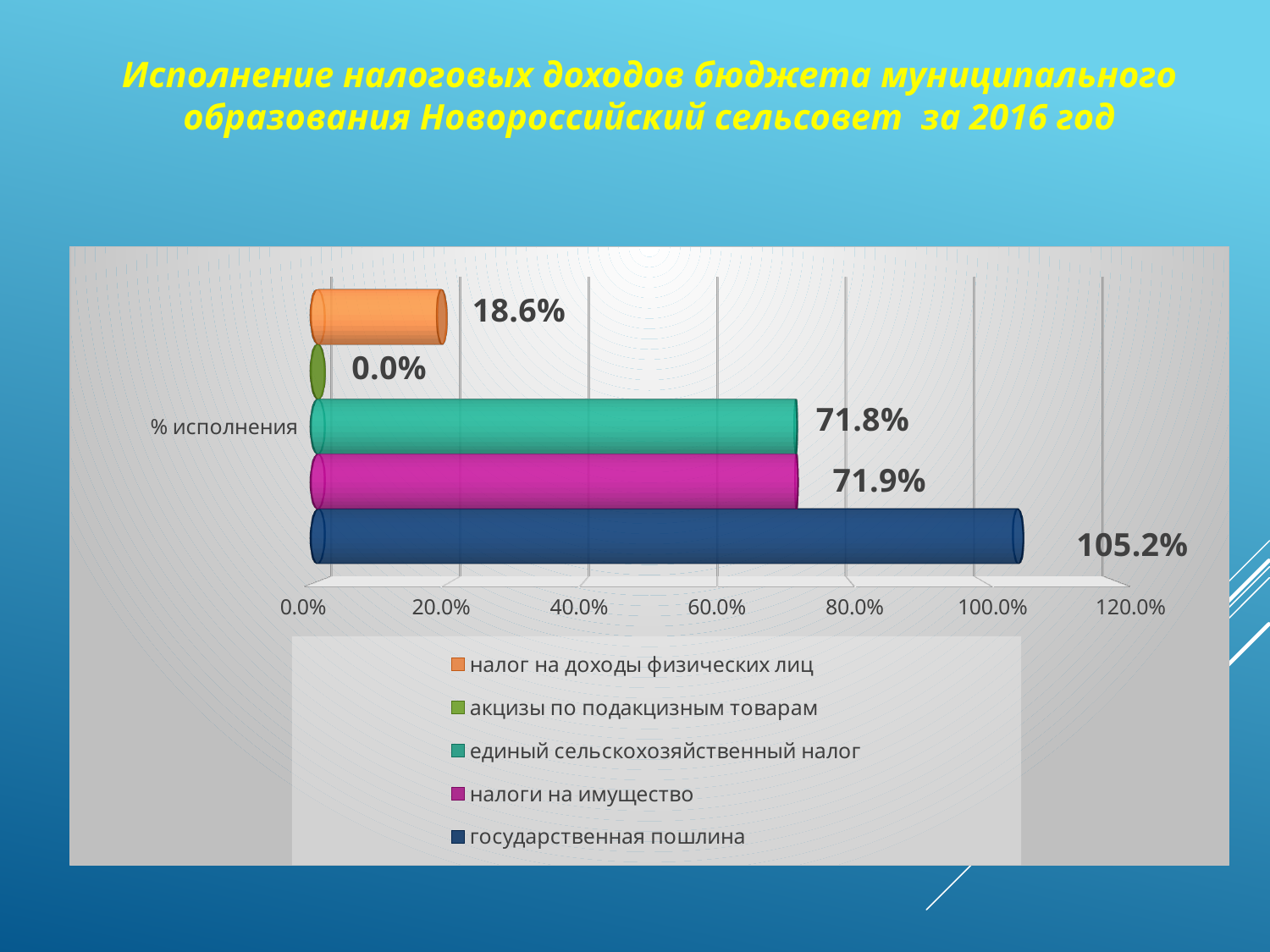
How many series does the legend list? 5 Is the value for государственная пошлина greater or less than 100.0%? greater What is the value for акцизы по подакцизным товарам? 0.0% Which series has the highest value? государственная пошлина Which series has the lowest value? акцизы по подакцизным товарам What is the value for налог на доходы физических лиц? 18.6% What kind of chart is shown on the slide? bar chart What is the value for единый сельскохозяйственный налог? 71.8% Which is larger, the value for налог на доходы физических лиц or the value for налоги на имущество? налоги на имущество What is the difference between the values for налоги на имущество and единый сельскохозяйственный налог? 0.1% What is the difference between the values for государственная пошлина and налоги на имущество? 33.3% What is the value for государственная пошлина? 105.2%